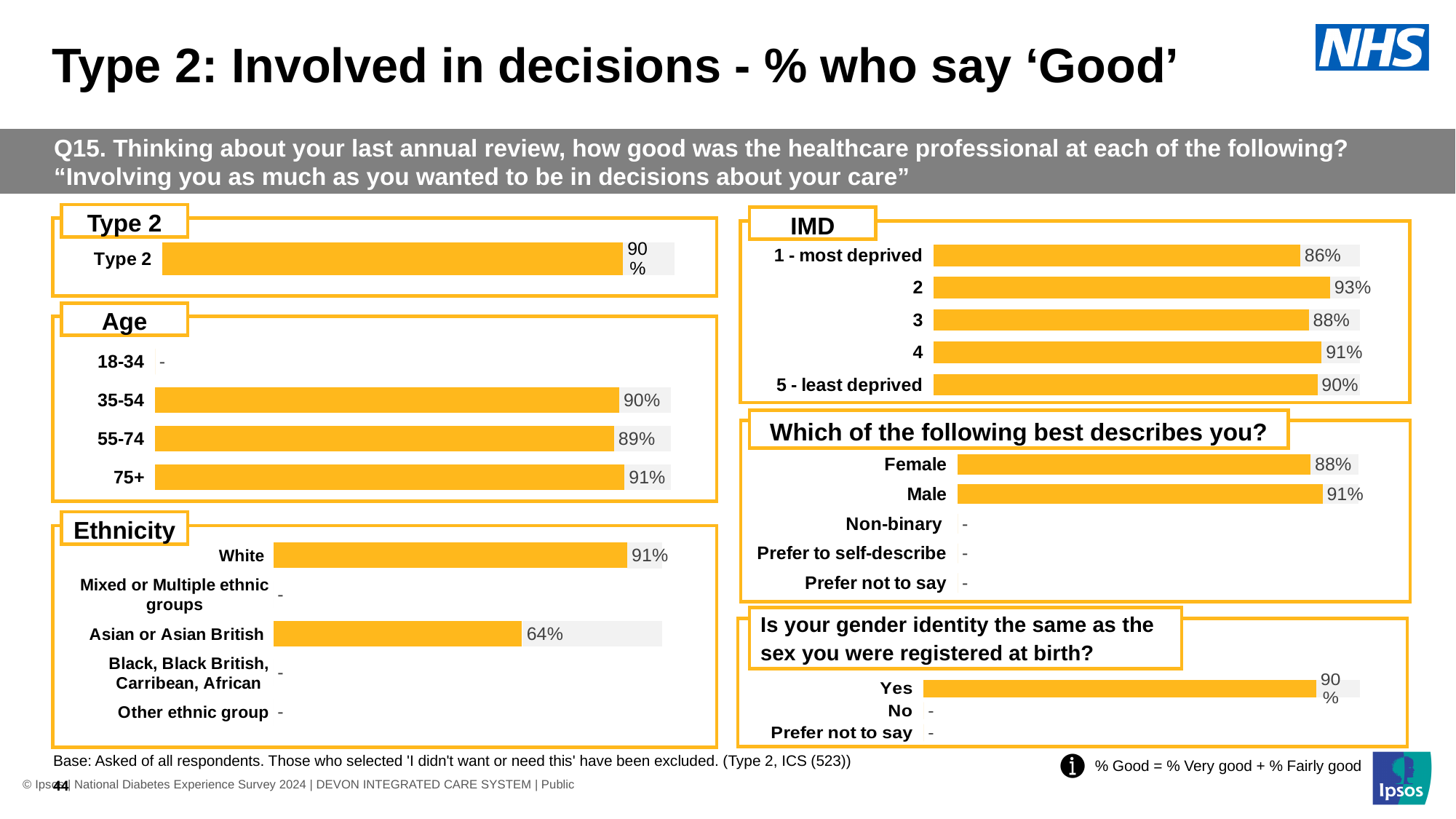
In the Age chart, which age group with a plotted value has the lowest percentage? 55-74 In the Type 2 chart, what percentage of Type 2 respondents say 'Good'? 90% In the Ethnicity chart, what is the value for Asian or Asian British? 64% In the 'Is your gender identity the same as the sex you were registered at birth?' chart, what is the value for Yes? 90% In the Age chart, what is the value for the 75+ age group? 91% In the IMD chart, which deprivation group has the lowest percentage? 1 - most deprived In the 'Which of the following best describes you?' chart, what is the value for Female? 88% In the Ethnicity chart, what is the difference between the White and Asian or Asian British values? 27 percentage points What type of chart is used in the IMD section? Bar chart In the IMD chart, which deprivation group has the highest percentage? 2 In the 'Which of the following best describes you?' chart, which is larger, Female or Male? Male In the IMD chart, what is the value for group 4? 91%